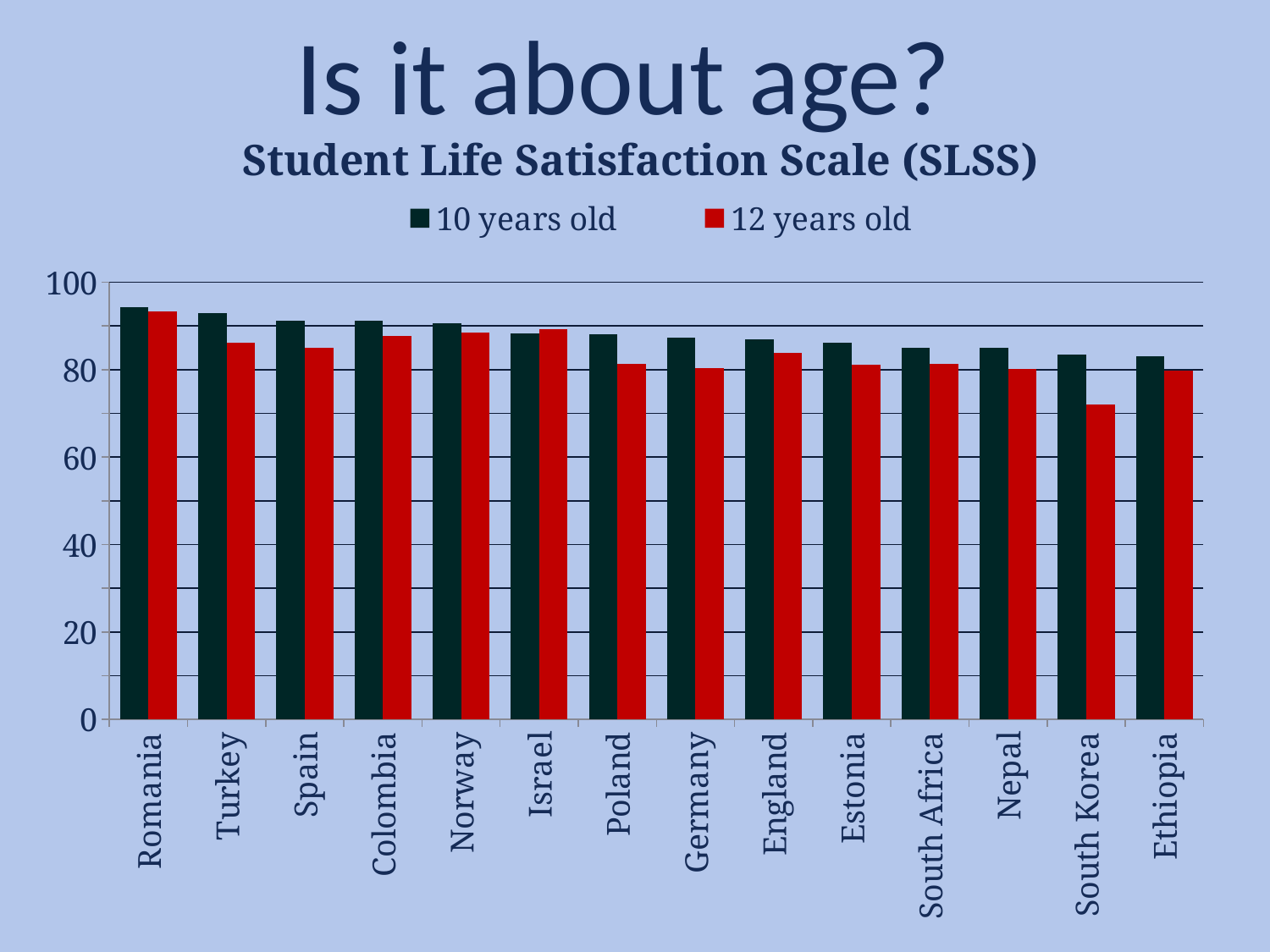
Which country has the lowest value for 12 years old? South Korea Is the value for 12 years old in Turkey greater or less than 80? greater How many countries are shown on the x axis? 14 Is the value for 10 years old in Romania greater or less than 90? greater Which is larger in Turkey, the value for 10 years old or for 12 years old? 10 years old How many series does the legend list? 2 Is the value for 10 years old in Ethiopia greater or less than 80? greater Which country has the highest value for 10 years old? Romania What colour are the bars for the 12 years old series? red Do the values for 10 years old rise or fall from left to right across the countries? fall What kind of chart is shown on the slide? bar chart